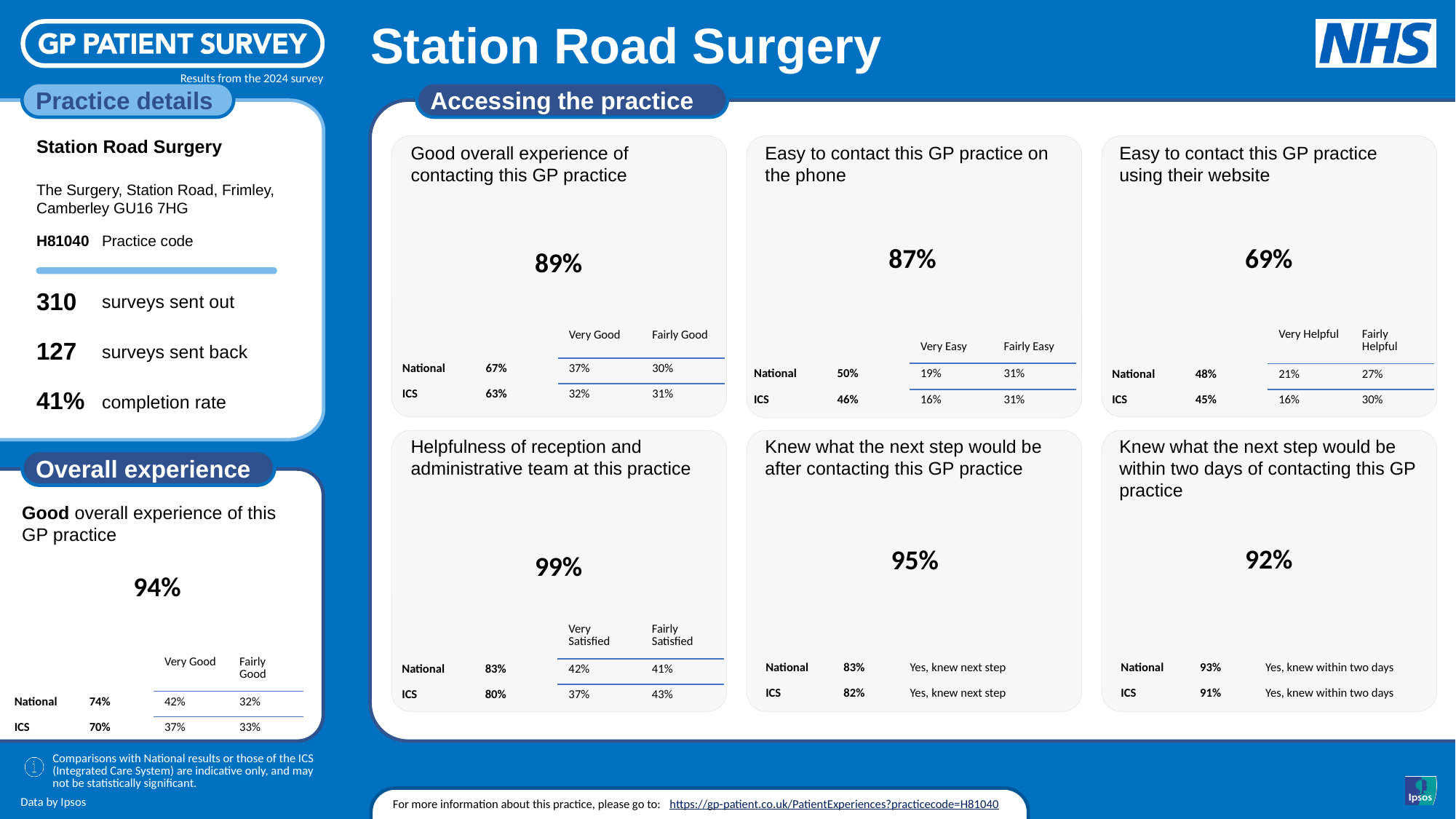
In the 'Knew what the next step would be after contacting this GP practice' panel, what is the difference between the practice's headline value and the National value? 12% How many result panels are shown under the 'Accessing the practice' heading? 6 In the 'Knew what the next step would be within two days of contacting this GP practice' panel, what is the ICS value? 91% Across the six 'Accessing the practice' panels, which panel has the highest headline percentage? Helpfulness of reception and administrative team at this practice Across the six 'Accessing the practice' panels, which panel has the lowest headline percentage? Easy to contact this GP practice using their website In the 'Easy to contact this GP practice using their website' panel, what is the ICS value? 45% In the 'Overall experience' section, what is the practice's headline percentage for good overall experience of this GP practice? 94% In the 'Easy to contact this GP practice on the phone' panel, what is the National value? 50% In the 'Overall experience' section, what is the difference between the National and ICS values? 4% In the 'Good overall experience of contacting this GP practice' panel, what is the practice's headline percentage? 89% In the 'Helpfulness of reception and administrative team at this practice' panel, what is the National 'Very Satisfied' value? 42% In the 'Easy to contact this GP practice on the phone' panel, which is larger: the National value or the ICS value? National